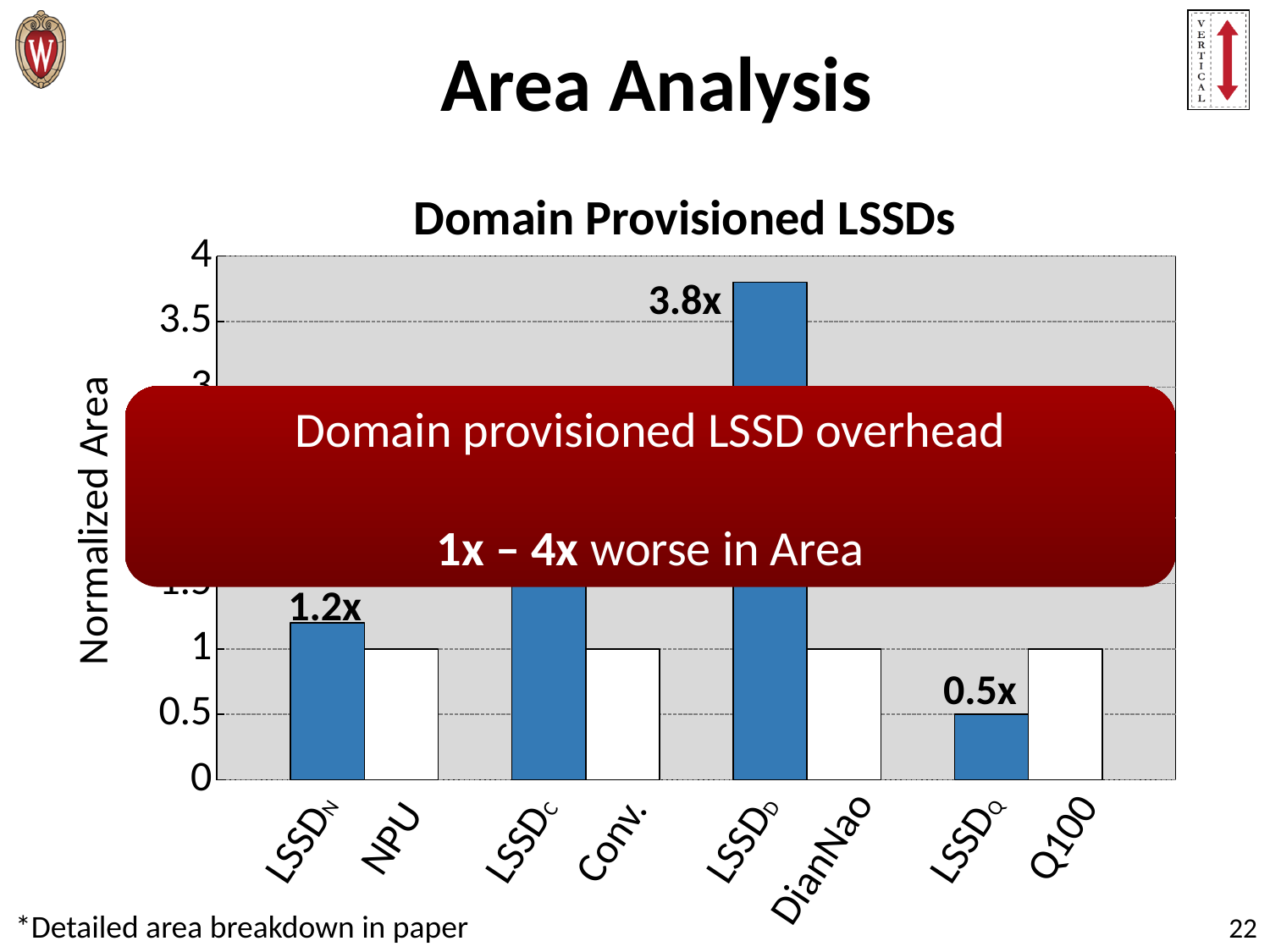
What is the difference between the normalized area of LSSD_D and LSSD_N? 2.6x What is the label on the y axis of the chart? Normalized Area Which category has the highest normalized area? LSSD_D What is the title of the chart? Domain Provisioned LSSDs Which category has the lowest normalized area? LSSD_Q What is the normalized area value shown for LSSD_D? 3.8x What kind of chart is shown on the slide? Bar chart What is the normalized area value shown for LSSD_N? 1.2x How many categories are shown on the x axis of the chart? 8 Is the normalized area for LSSD_D greater or less than 3.5? greater Which has a larger normalized area, LSSD_N or LSSD_Q? LSSD_N What is the normalized area value shown for LSSD_Q? 0.5x